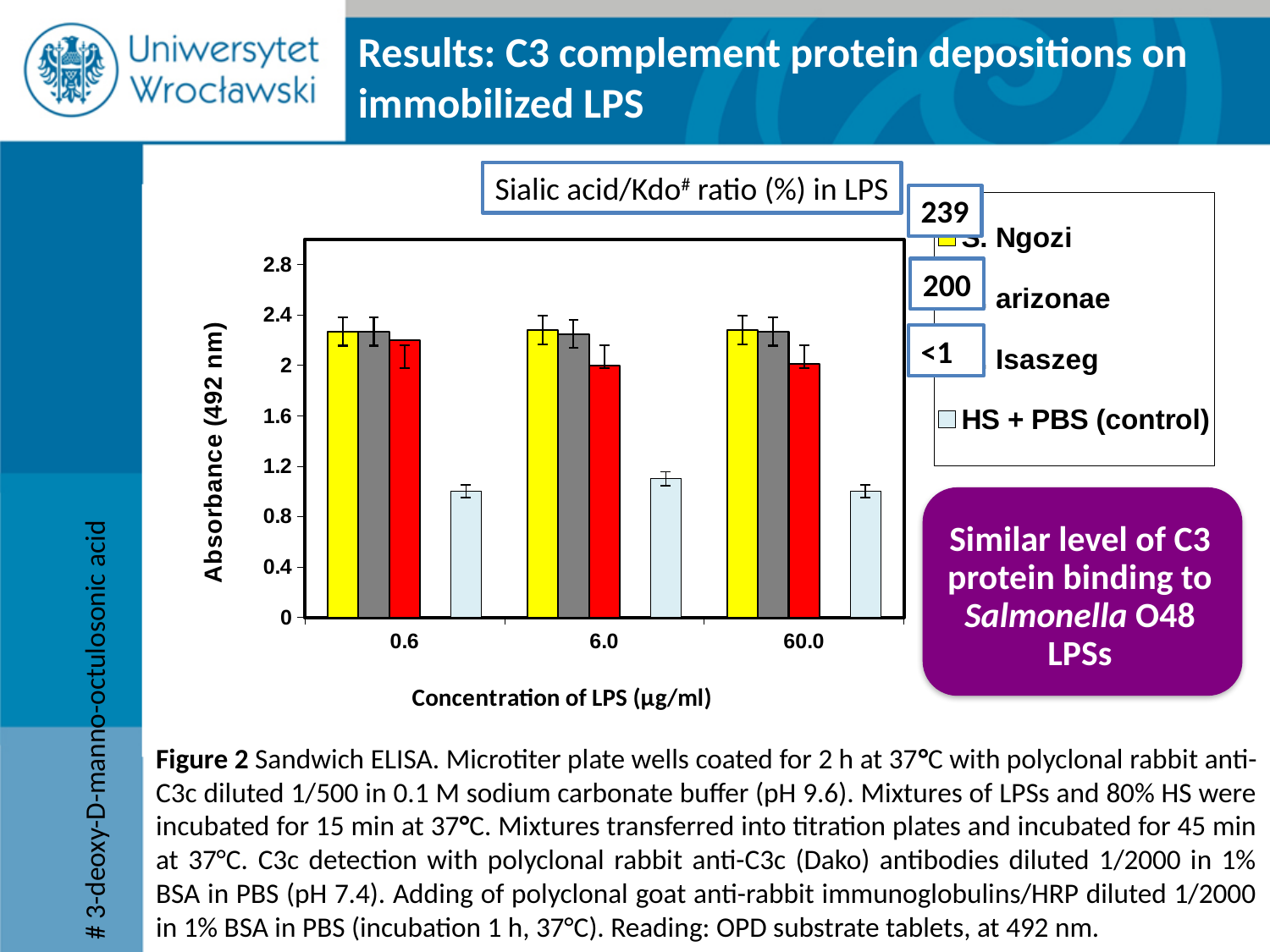
At 0.6 µg/ml, which has the higher absorbance: S. Ngozi or HS + PBS (control)? S. Ngozi How many series does the legend list? 4 What is the title of the x axis? Concentration of LPS (µg/ml) Is the absorbance for arizonae at 60.0 µg/ml greater or less than 2? greater How many LPS concentration categories are shown on the x axis? 3 At 60.0 µg/ml, which has the higher absorbance: Isaszeg or HS + PBS (control)? Isaszeg Is the absorbance for S. Ngozi at 0.6 µg/ml greater or less than 2? greater What is the title of the y axis? Absorbance (492 nm) Which series has the lowest absorbance at 6.0 µg/ml? HS + PBS (control) Is the absorbance for HS + PBS (control) at 0.6 µg/ml greater or less than 1.2? less What kind of chart is shown on the slide? bar chart